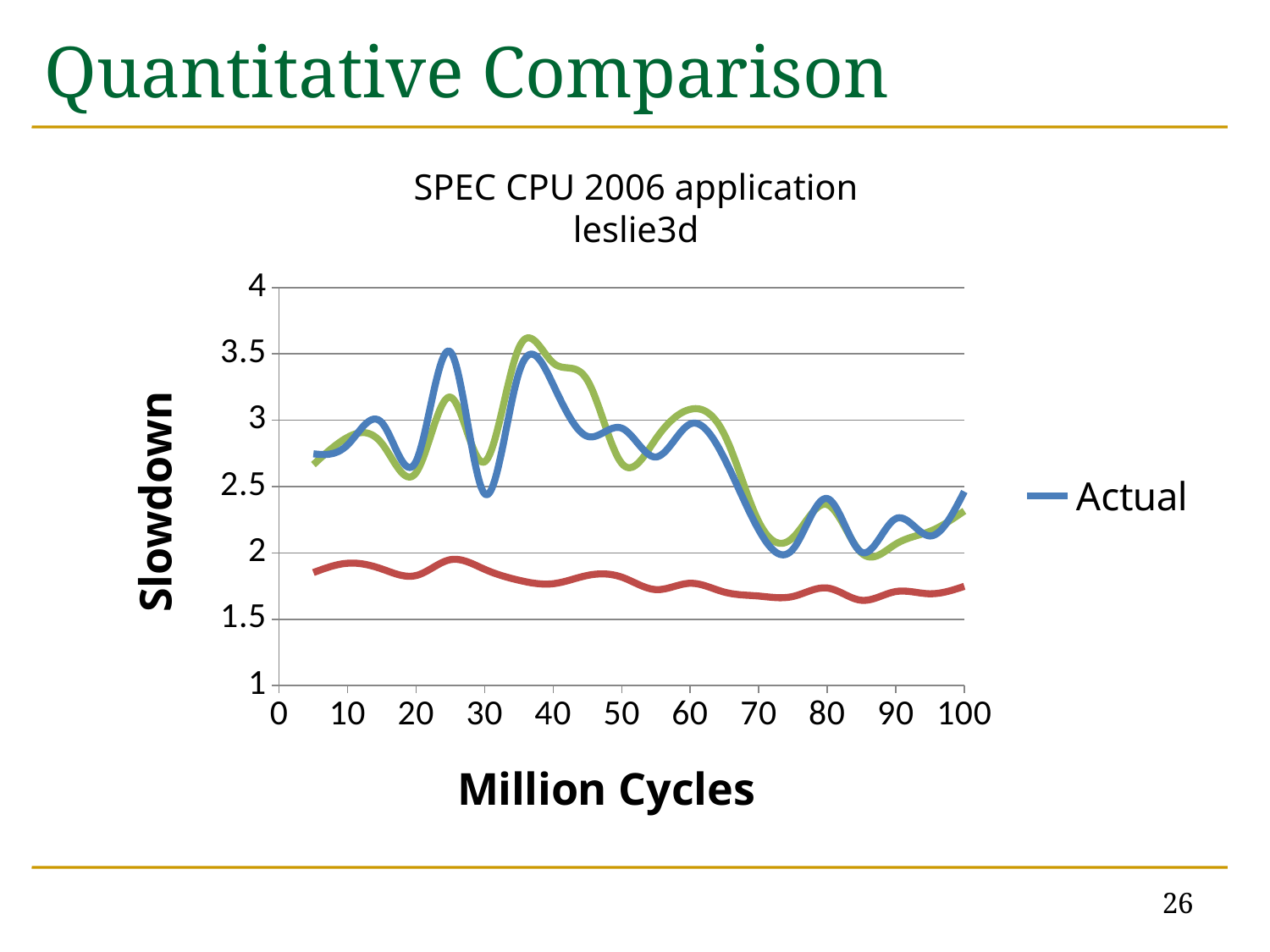
What kind of chart is shown on the slide? line chart Is the Actual slowdown at 37 million cycles greater or less than 3? greater Is the Actual slowdown at 85 million cycles greater or less than 2.5? less Is the Actual slowdown at 25 million cycles greater or less than 3? greater Which has the higher Actual slowdown: 25 million cycles or 75 million cycles? 25 million cycles Which has the higher Actual slowdown: 5 million cycles or 100 million cycles? 5 million cycles What is the title of the chart? SPEC CPU 2006 application leslie3d How many series does the chart's legend list? 1 Overall, does the Actual slowdown rise or fall from 0 to 100 million cycles? fall What is the label of the x axis? Million Cycles